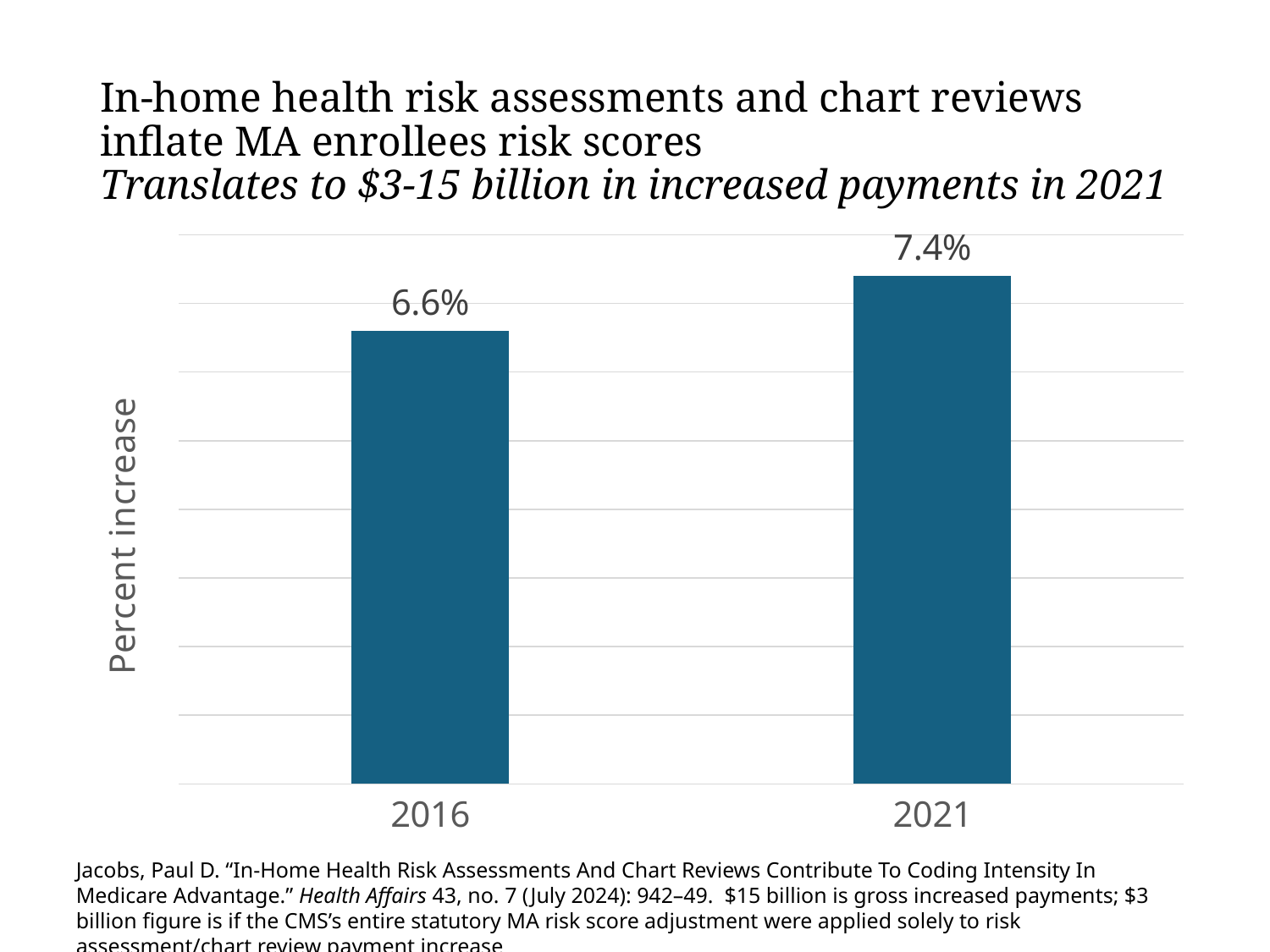
How many years are plotted on the chart? 2 Does the percent increase rise or fall from 2016 to 2021? rise What is the percent increase shown for 2016? 6.6% What is the difference in percent increase between 2021 and 2016? 0.8 percentage points What is the percent increase shown for 2021? 7.4% Which year has the higher percent increase? 2021 Is the value for 2021 larger or smaller than the value for 2016? larger Which year has the lower percent increase? 2016 What kind of chart is shown on the slide? bar chart What is the label on the vertical axis of the chart? Percent increase What colour are the bars in the chart? dark blue